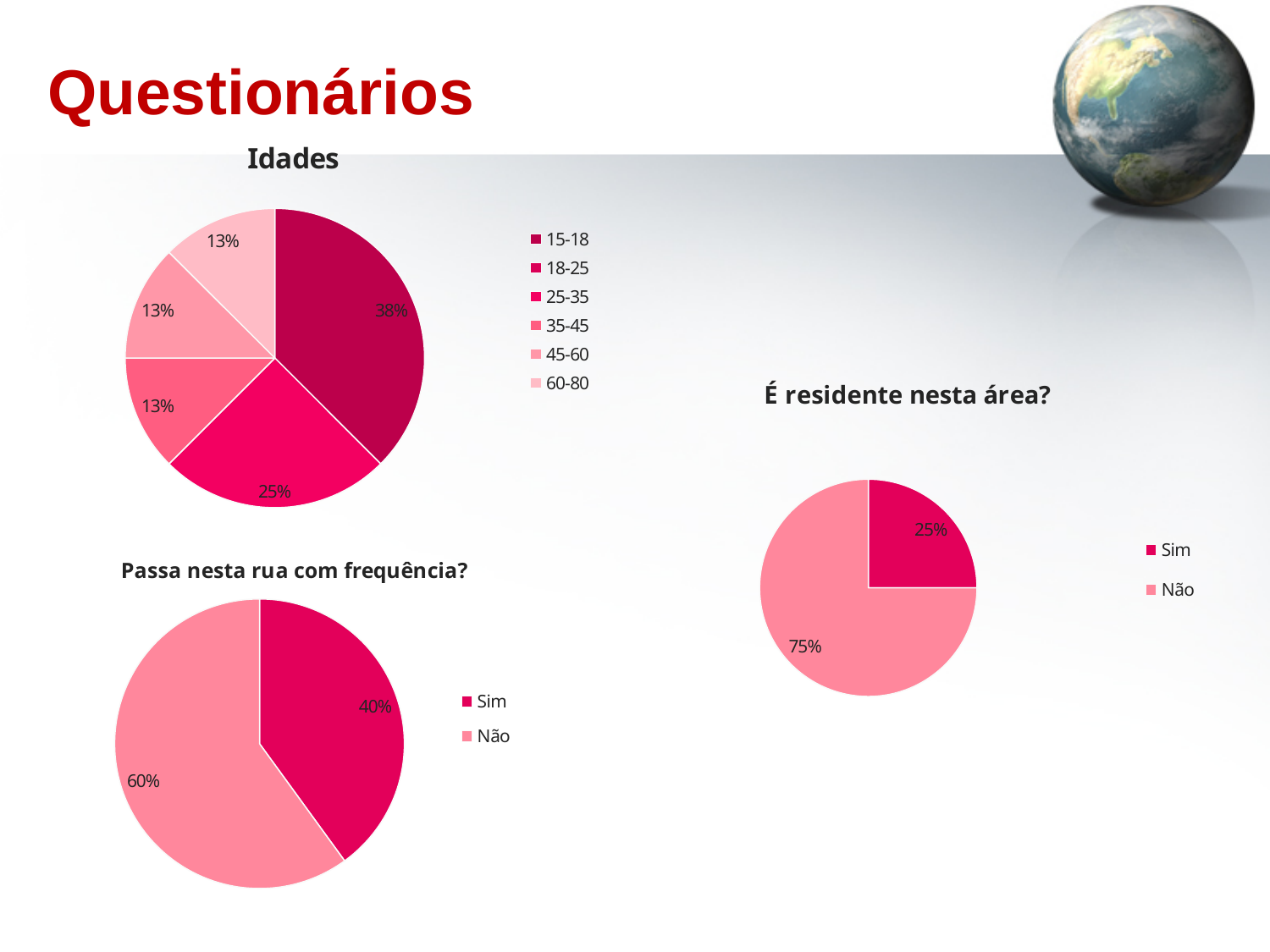
In the 'É residente nesta área?' chart, what share answered 'Sim'? 25% In the 'Passa nesta rua com frequência?' chart, what share answered 'Não'? 60% In the 'Idades' chart, what share is shown for the 15-18 age group? 38% In the 'É residente nesta área?' chart, what share answered 'Não'? 75% What kind of chart is the 'Idades' chart? Pie chart In the 'Passa nesta rua com frequência?' chart, which answer has the larger share, 'Sim' or 'Não'? Não In the 'Idades' chart, which age group has the largest slice? 15-18 How many pie charts are shown on the slide? 3 In the 'Passa nesta rua com frequência?' chart, what share answered 'Sim'? 40% How many entries does the legend of the 'Idades' chart list? 6 In the 'É residente nesta área?' chart, what is the difference between the 'Não' and 'Sim' shares? 50%